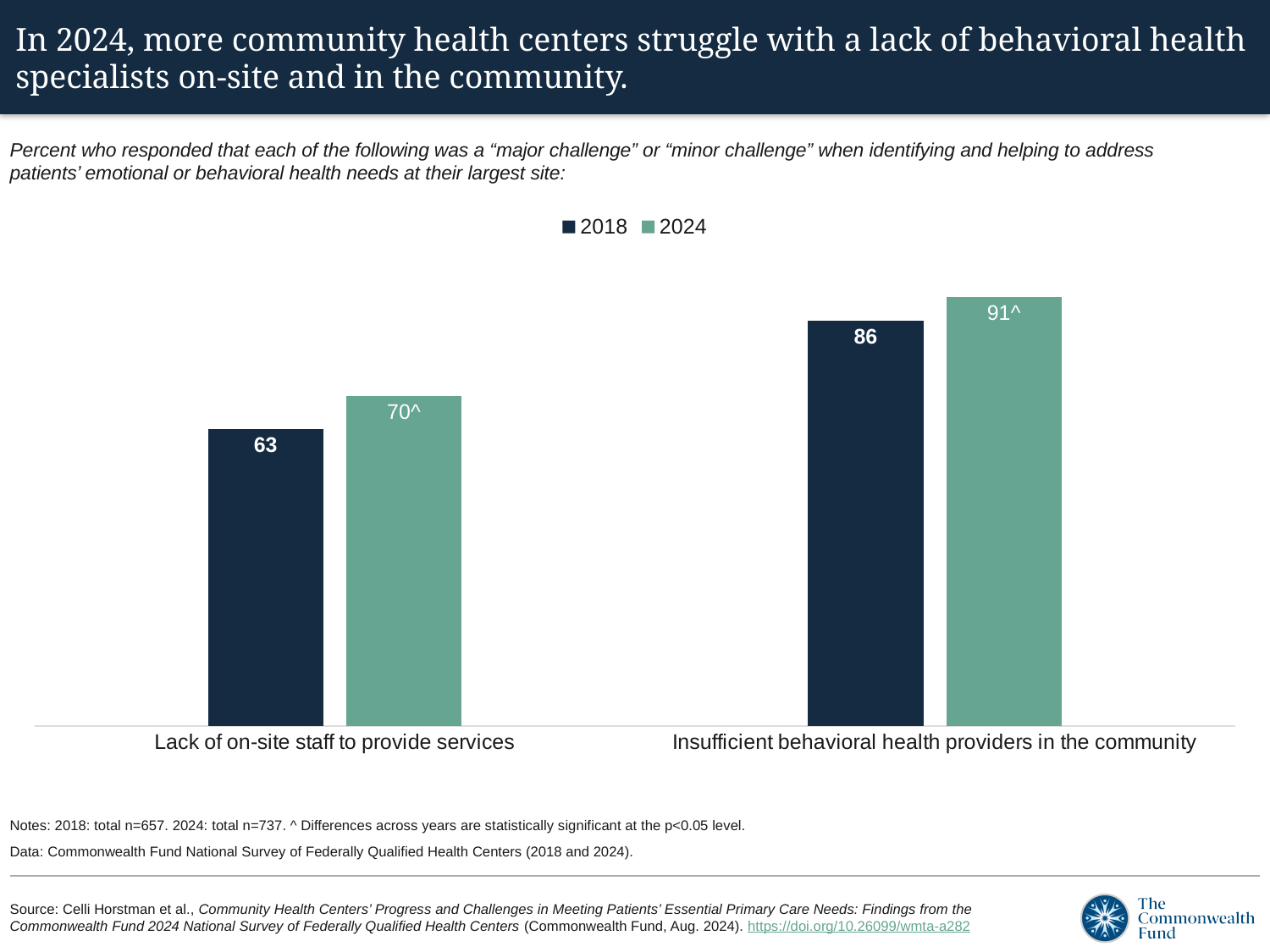
What kind of chart is shown on the slide? Bar chart What is the difference between the 2024 and 2018 values for "Lack of on-site staff to provide services"? 7 What is the 2024 value for "Lack of on-site staff to provide services"? 70^ Which category has the highest 2024 value? Insufficient behavioral health providers in the community What is the 2024 value for "Insufficient behavioral health providers in the community"? 91^ How many series does the legend list? 2 What is the difference between the 2024 and 2018 values for "Insufficient behavioral health providers in the community"? 5 How many categories are shown on the x axis? 2 Which category has the lowest 2018 value? Lack of on-site staff to provide services For "Insufficient behavioral health providers in the community", which year has the larger value, 2018 or 2024? 2024 What is the 2018 value for "Insufficient behavioral health providers in the community"? 86 What is the 2018 value for "Lack of on-site staff to provide services"? 63